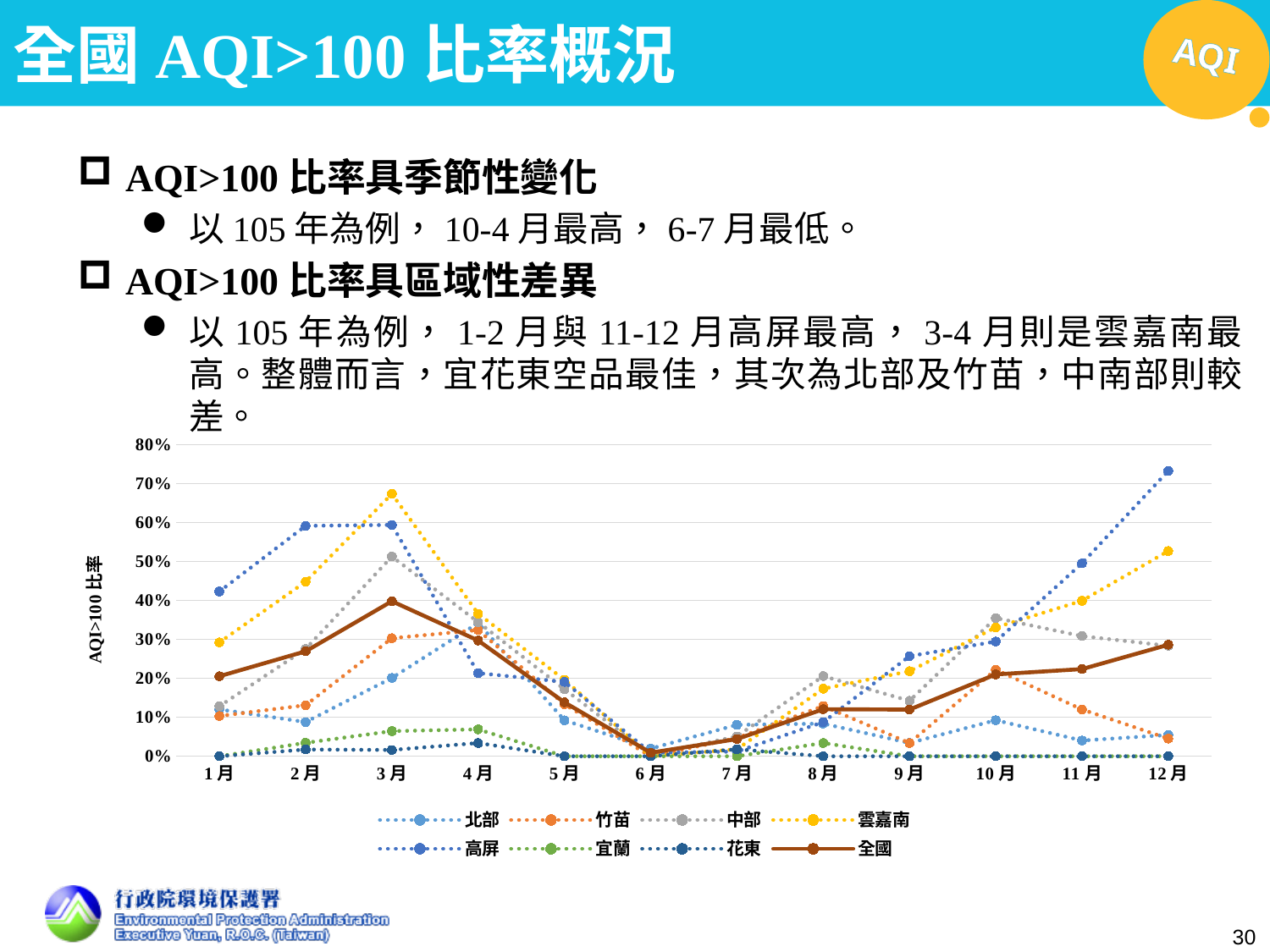
In which month does the 全國 series reach its highest value? 3月 What kind of chart is shown on the slide? line chart In 3月, which series has the larger value, 雲嘉南 or 高屏? 雲嘉南 Is the value for 雲嘉南 in 3月 greater or less than 60%? greater How many series does the chart's legend list? 8 Is the value for 高屏 in 12月 greater or less than 70%? greater In 12月, which series has the larger value, 高屏 or 雲嘉南? 高屏 Which series is drawn as a solid line rather than a dotted line? 全國 In which month does the 全國 series reach its lowest value? 6月 How many months are plotted along the x axis of the chart? 12 Is the value for 全國 in 3月 greater or less than 30%? greater Does the 全國 series rise or fall from 3月 to 6月? fall